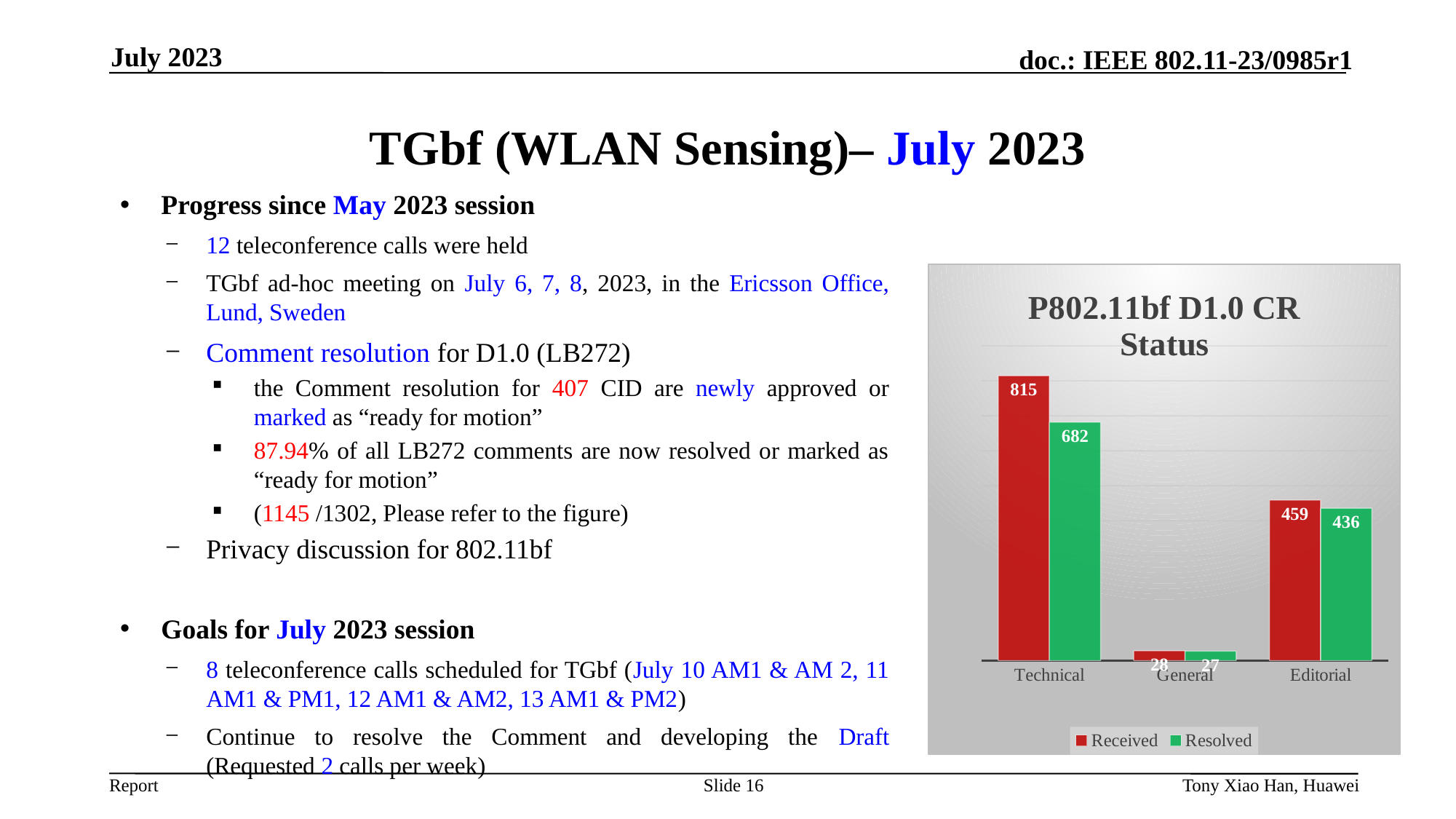
What is the Received value for Technical? 815 Which category has the highest Received value? Technical Which category has the lowest Resolved value? General What is the difference between Received and Resolved for Editorial? 23 How many series does the legend list? 2 Which is larger, the Resolved value for Technical or the Received value for Editorial? Resolved value for Technical What kind of chart is shown? bar chart What is the difference between Received and Resolved for Technical? 133 What is the Resolved value for Editorial? 436 How many categories are shown on the x axis? 3 What is the title of the chart? P802.11bf D1.0 CR Status What is the Received value for General? 28